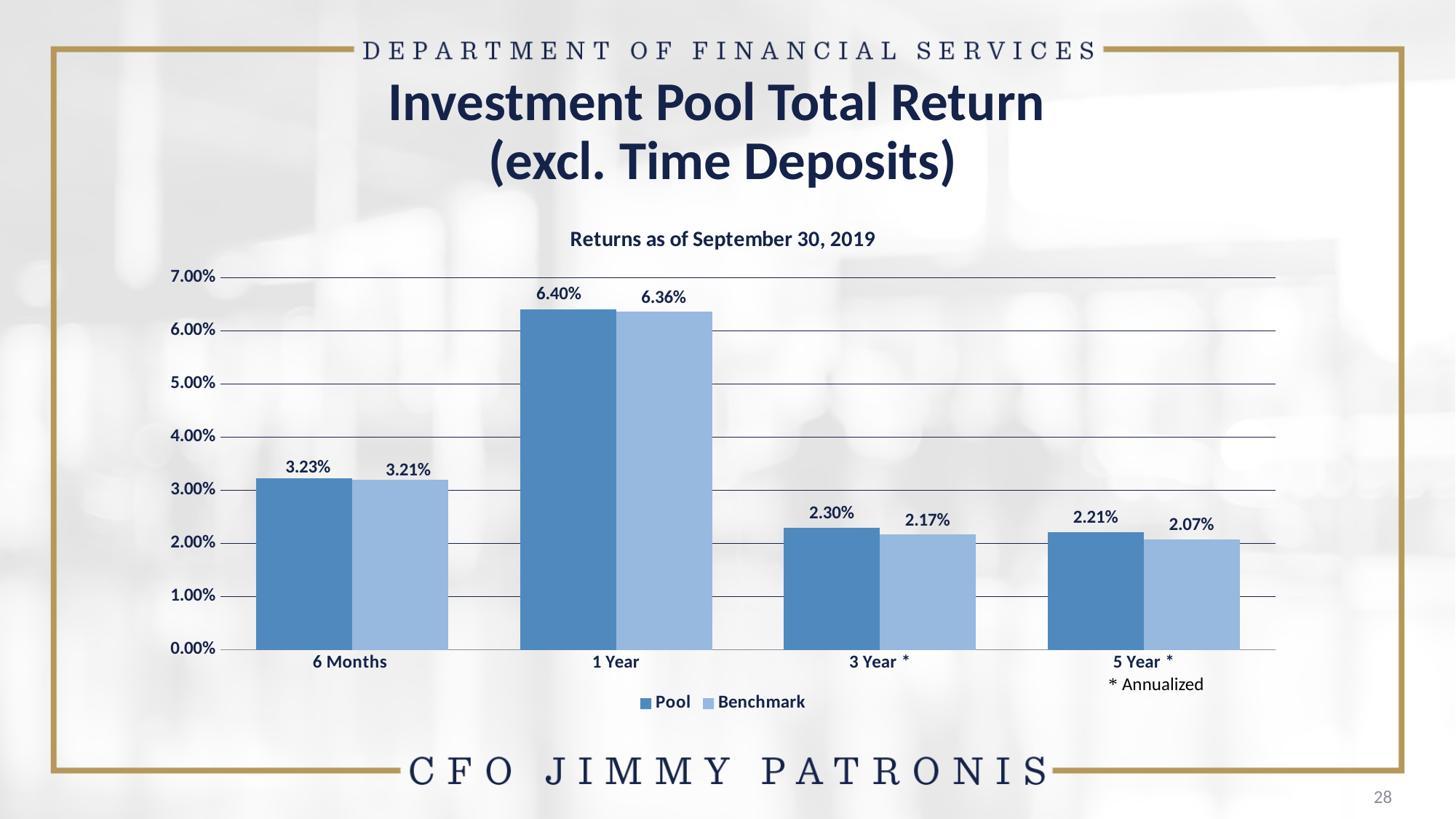
Which is larger for the 5 Year period, the Pool return or the Benchmark return? Pool What is the Benchmark return for 6 Months? 3.21% What is the Benchmark return for the 5 Year period? 2.07% What is the chart's subtitle above the plot area? Returns as of September 30, 2019 What kind of chart is shown on the slide? Bar chart Which period has the lowest Benchmark return? 5 Year Which period has the highest Pool return? 1 Year What is the Pool return for the 1 Year period? 6.40% Is the Pool return for 6 Months greater or less than 3.00%? greater How many time periods are shown on the x axis? 4 What is the difference between the Pool and Benchmark returns for the 3 Year period? 0.13% How many series does the legend list? 2